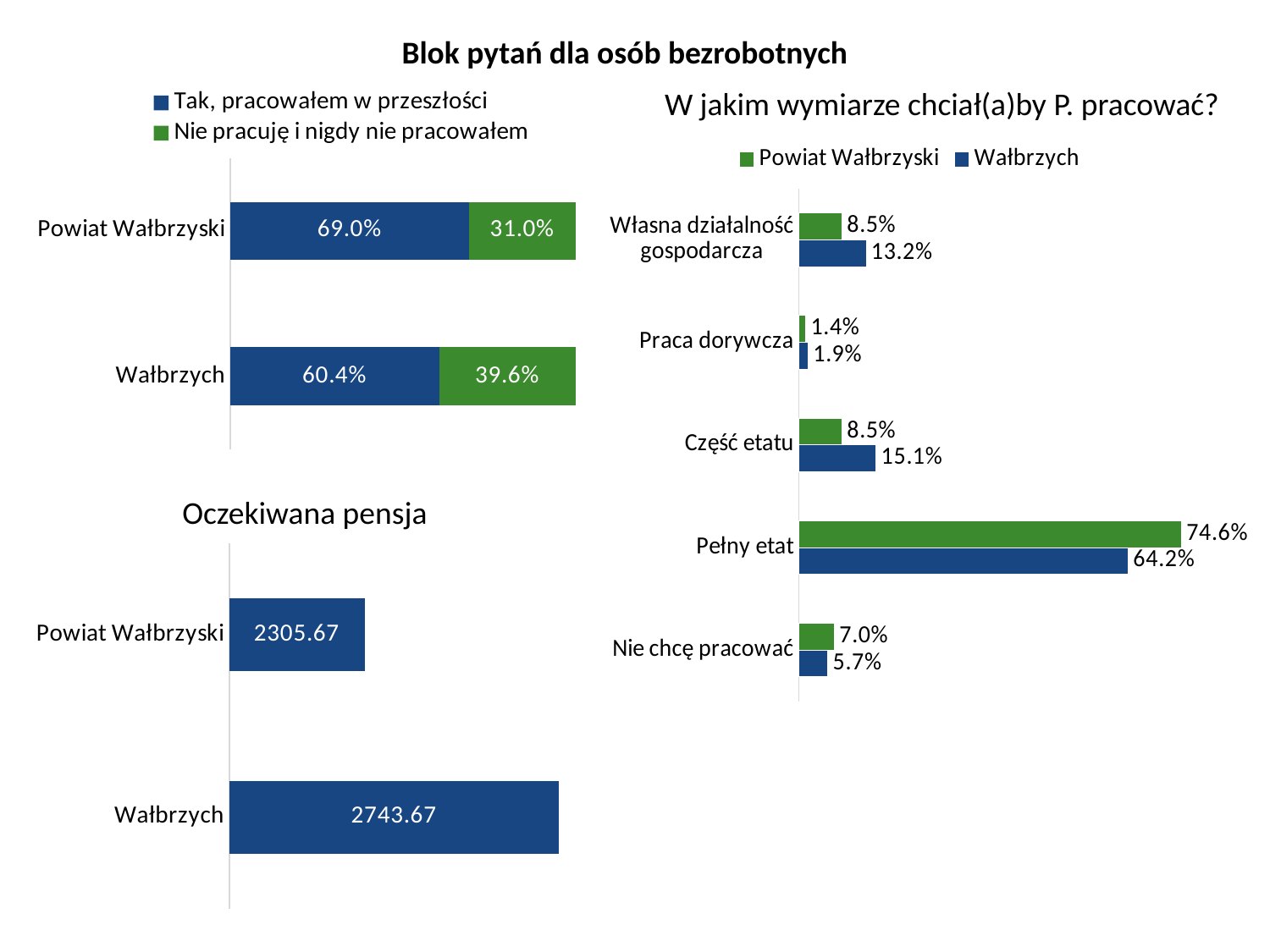
In the chart 'Oczekiwana pensja', what is the difference between the values for Wałbrzych and Powiat Wałbrzyski? 438.00 In the chart 'W jakim wymiarze chciał(a)by P. pracować?', what is the value for Pełny etat in the Powiat Wałbrzyski series? 74.6% In the top-left stacked bar chart, how many series does the legend list? 2 In the chart 'Oczekiwana pensja', what is the value for Wałbrzych? 2743.67 In the top-left stacked bar chart, what is the value of 'Tak, pracowałem w przeszłości' for Powiat Wałbrzyski? 69.0% In the chart 'Oczekiwana pensja', what is the value for Powiat Wałbrzyski? 2305.67 In the chart 'Oczekiwana pensja', which category has the higher value? Wałbrzych In the chart 'W jakim wymiarze chciał(a)by P. pracować?', how many categories are shown? 5 In the chart 'W jakim wymiarze chciał(a)by P. pracować?', what is the value for Część etatu in the Wałbrzych series? 15.1% In the top-left stacked bar chart, what is the value of 'Nie pracuję i nigdy nie pracowałem' for Wałbrzych? 39.6% In the chart 'W jakim wymiarze chciał(a)by P. pracować?', which category has the lowest value in the Wałbrzych series? Praca dorywcza In the chart 'W jakim wymiarze chciał(a)by P. pracować?', what is the difference between the Powiat Wałbrzyski and Wałbrzych values for Pełny etat? 10.4%